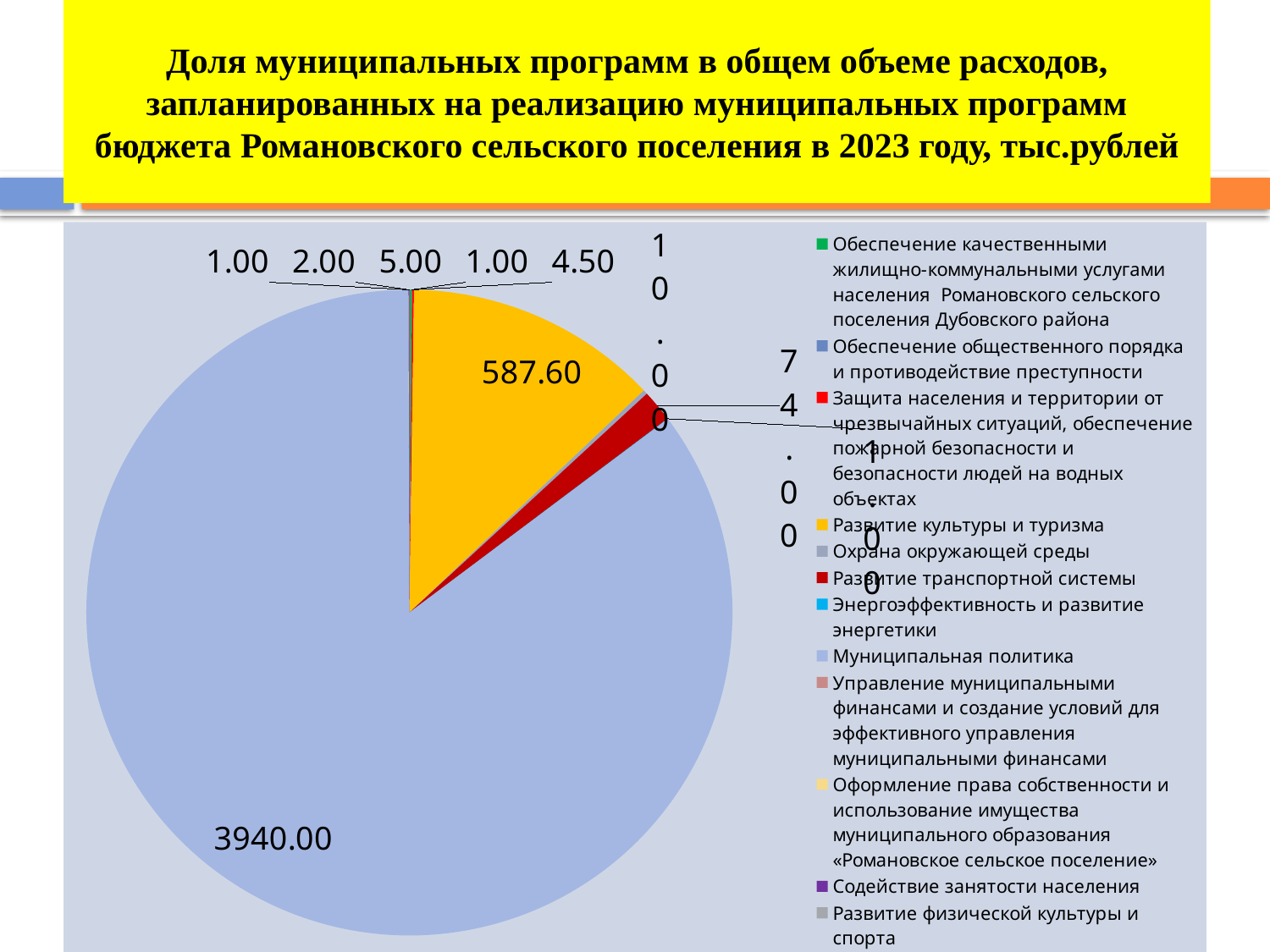
What is the last entry listed in the legend? Развитие физической культуры и спорта What is the value shown on the largest slice of the pie chart? 3940.00 How many entries does the legend of the pie chart list? 12 Which is larger: the slice labelled 587.60 or the slice labelled 74.00? 587.60 What is the value shown on the yellow slice (Развитие культуры и туризма)? 587.60 What is the difference between the slice labelled 587.60 and the slice labelled 74.00? 513.60 What is the difference between the largest slice (3940.00) and the yellow slice (587.60)? 3352.40 What is the first entry listed in the legend? Обеспечение качественными жилищно-коммунальными услугами населения Романовского сельского поселения Дубовского района What kind of chart is shown on the slide? pie chart What is the value shown for the dark red slice (Развитие транспортной системы)? 74.00 Is the value of the largest slice greater or less than 3000? greater